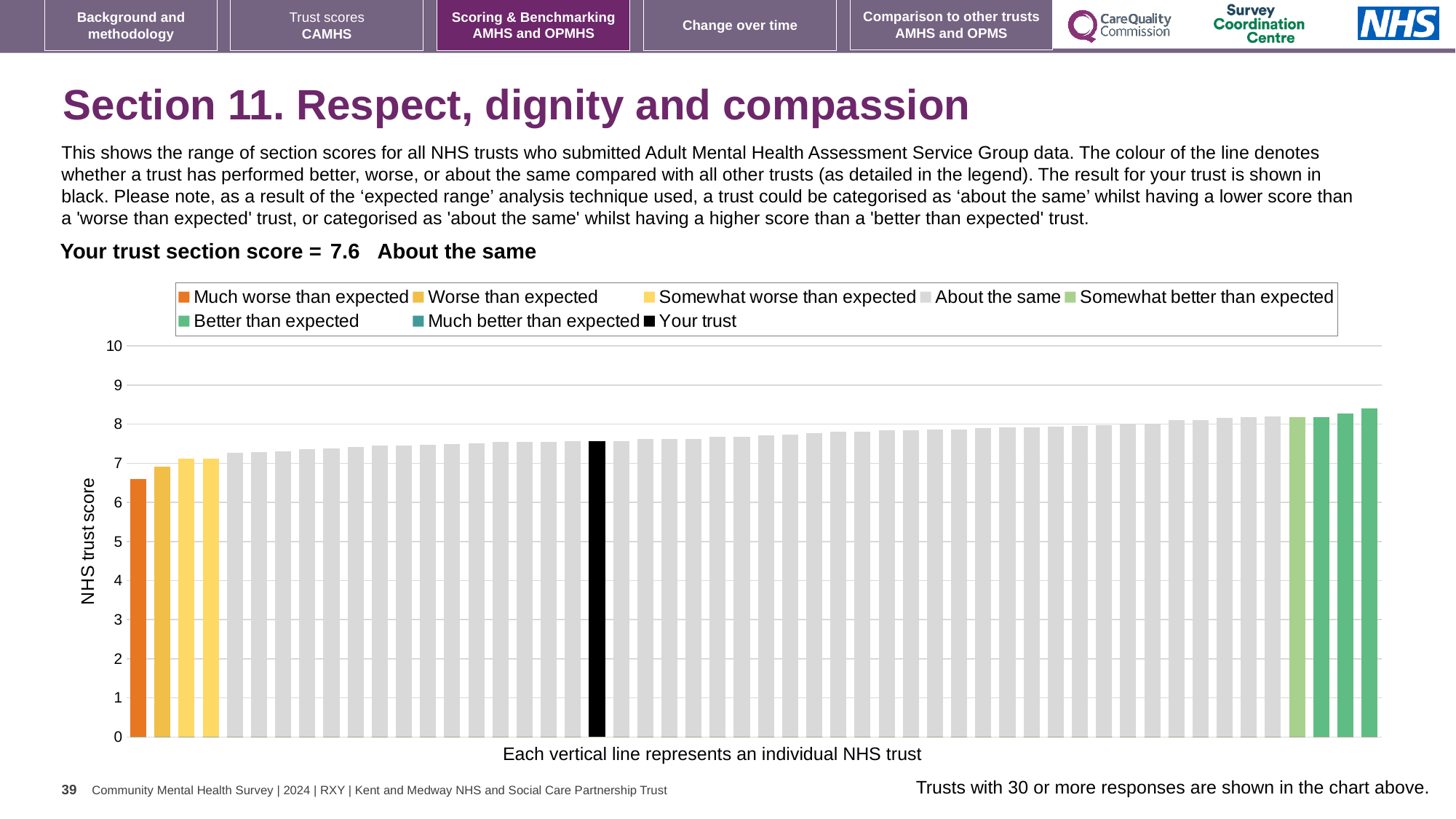
What kind of chart is shown on the slide? bar chart What is the section score for your trust? 7.6 Which category is your trust's section score placed in? About the same What colour is the bar representing your trust? black Which legend category does the highest bar in the chart belong to? Better than expected How many entries does the chart legend list? 8 Is the value of the tallest bar greater or less than 8? greater Do the bar values rise or fall from left to right along the x axis? rise How many bars are coloured as 'Better than expected'? 3 Is the value of the 'Much worse than expected' bar greater or less than 7? less Which legend category does the lowest bar in the chart belong to? Much worse than expected Is the value for your trust greater or less than 7? greater